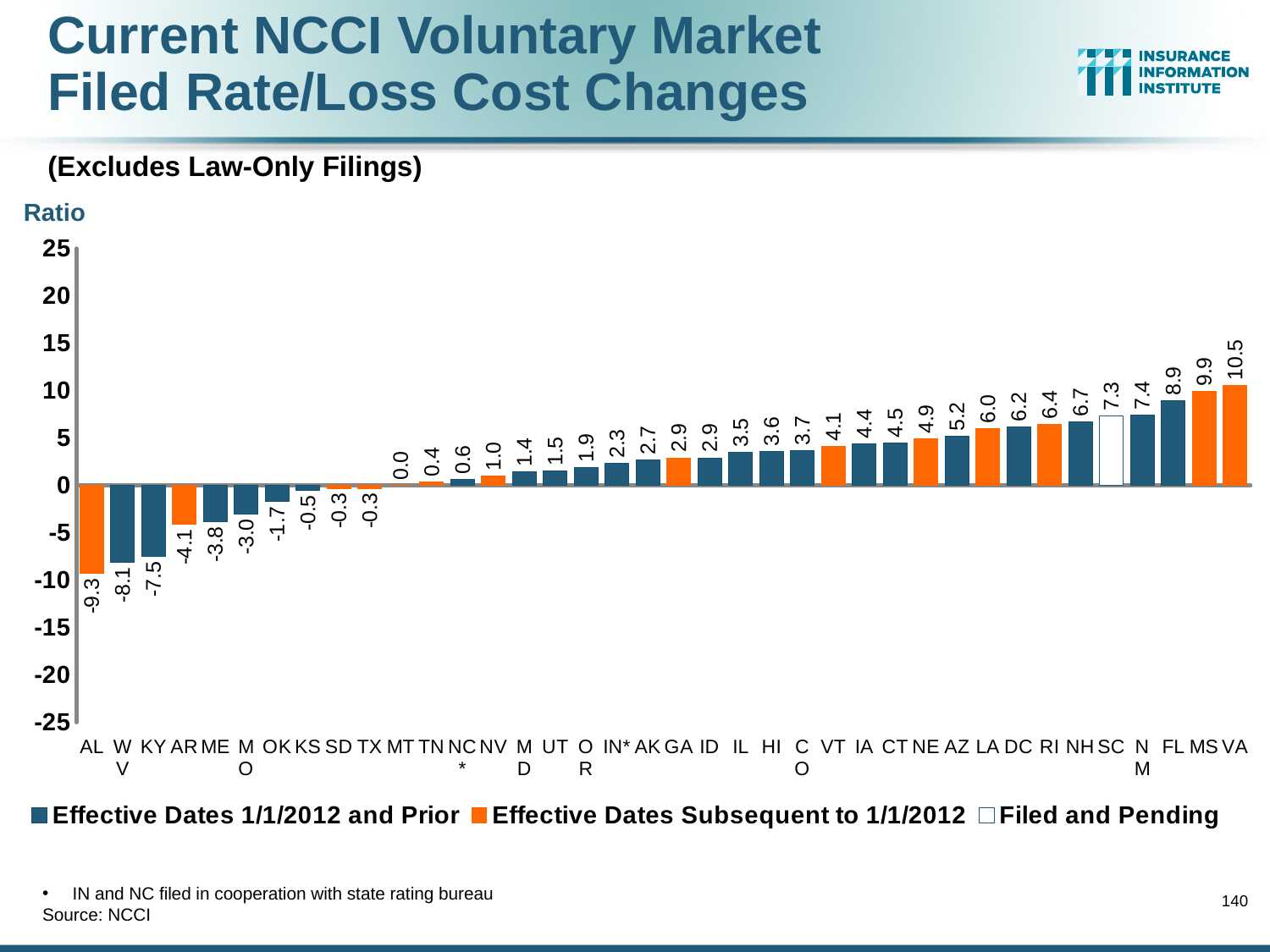
What is the value for VA? 10.5 Which state has the highest value? VA Do the values rise or fall from left to right along the x axis? Rise What is the difference between the values for VA and AL? 19.8 What is the value for MT? 0.0 Which has a larger value, FL or MS? MS Which state has the lowest value? AL How many series does the legend list? 3 What kind of chart is this? Bar chart What is the value for AL? -9.3 Which state's bar is in the 'Filed and Pending' series? SC How many states are shown on the x axis? 38